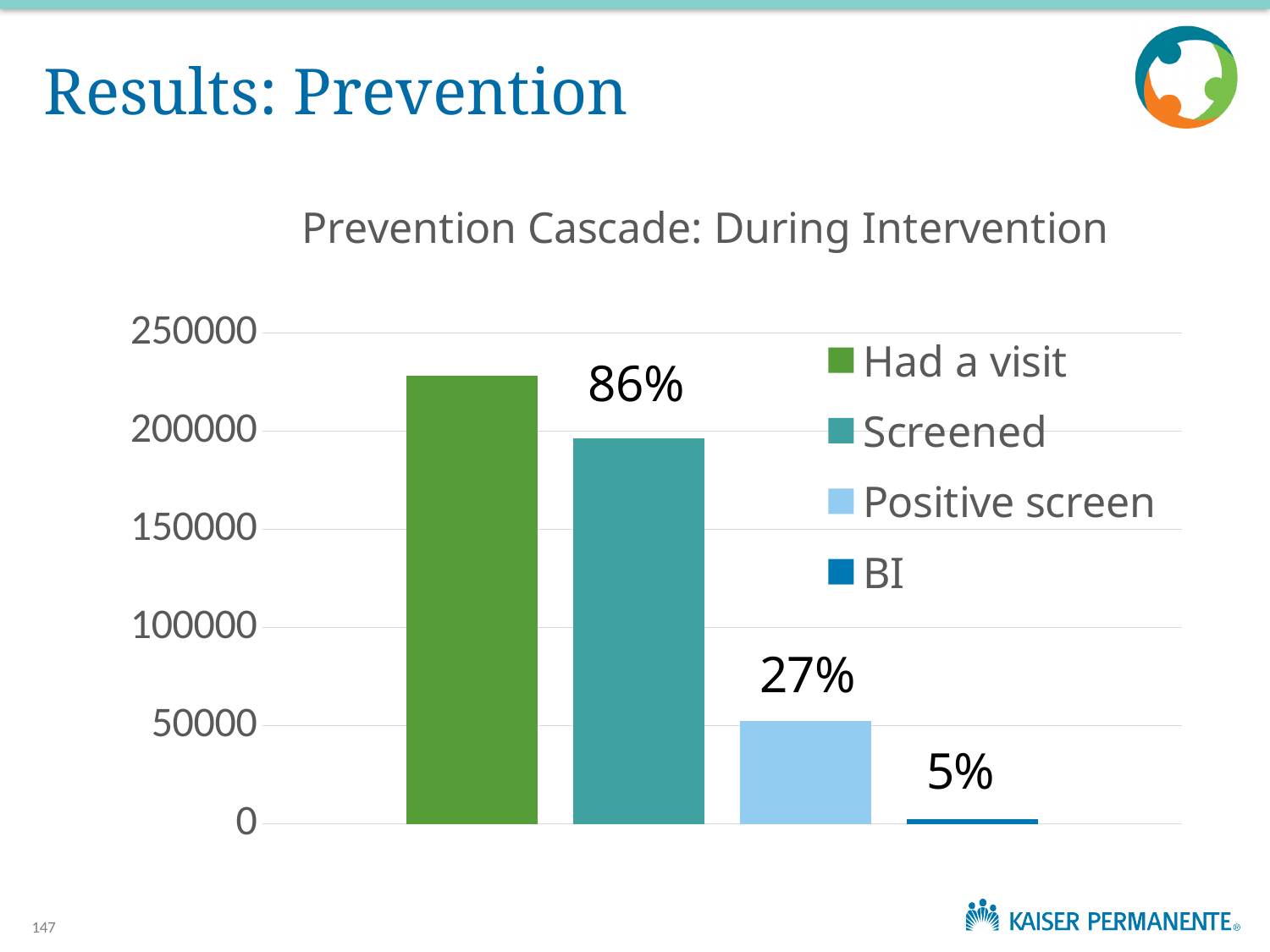
Is the value for Had a visit greater or less than 200000? greater What is the title of the chart? Prevention Cascade: During Intervention What percentage label is printed above the BI bar? 5% How many bars are plotted in the chart? 4 Which series has the shortest bar? BI Do the bar values rise or fall from left to right across the chart? fall What kind of chart is shown on the slide? Bar chart What percentage label is printed above the Positive screen bar? 27% How many series does the legend list? 4 Which series has the tallest bar? Had a visit What percentage label is printed above the Screened bar? 86% Is the value for Positive screen greater or less than 100000? less